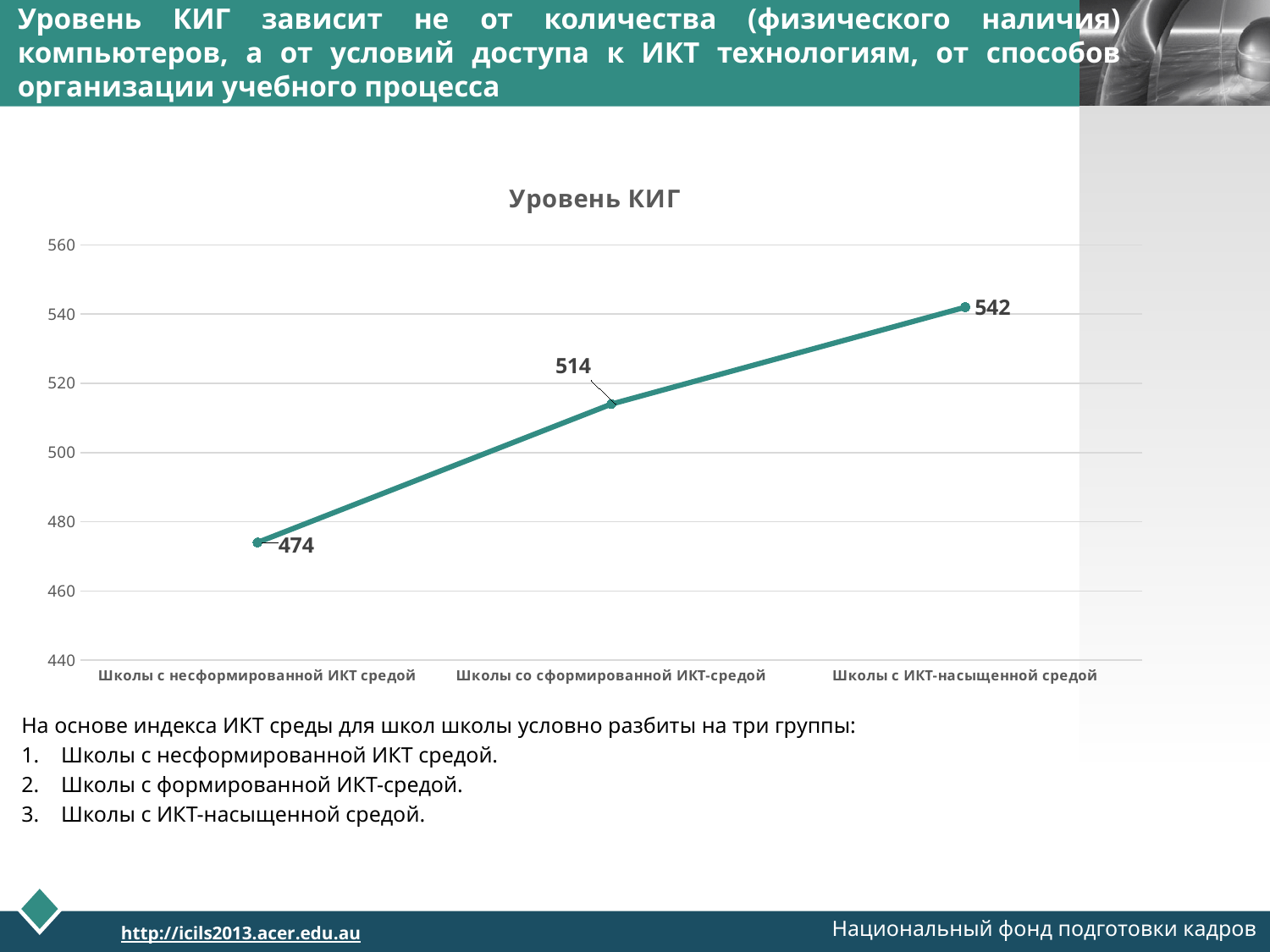
What is the difference between the values for Школы с ИКТ-насыщенной средой and Школы с несформированной ИКТ средой? 68 How many categories are plotted on the chart? 3 What is the difference between the values for Школы со сформированной ИКТ-средой and Школы с несформированной ИКТ средой? 40 What kind of chart is shown on the slide? line chart What is the value for Школы с несформированной ИКТ средой? 474 Which category has the lowest value? Школы с несформированной ИКТ средой Which is larger, the value for Школы со сформированной ИКТ-средой or Школы с ИКТ-насыщенной средой? Школы с ИКТ-насыщенной средой What is the value for Школы со сформированной ИКТ-средой? 514 Is the value for Школы со сформированной ИКТ-средой greater or less than 500? greater Do the values rise or fall from left to right along the x axis? rise What is the value for Школы с ИКТ-насыщенной средой? 542 Which category has the highest value? Школы с ИКТ-насыщенной средой